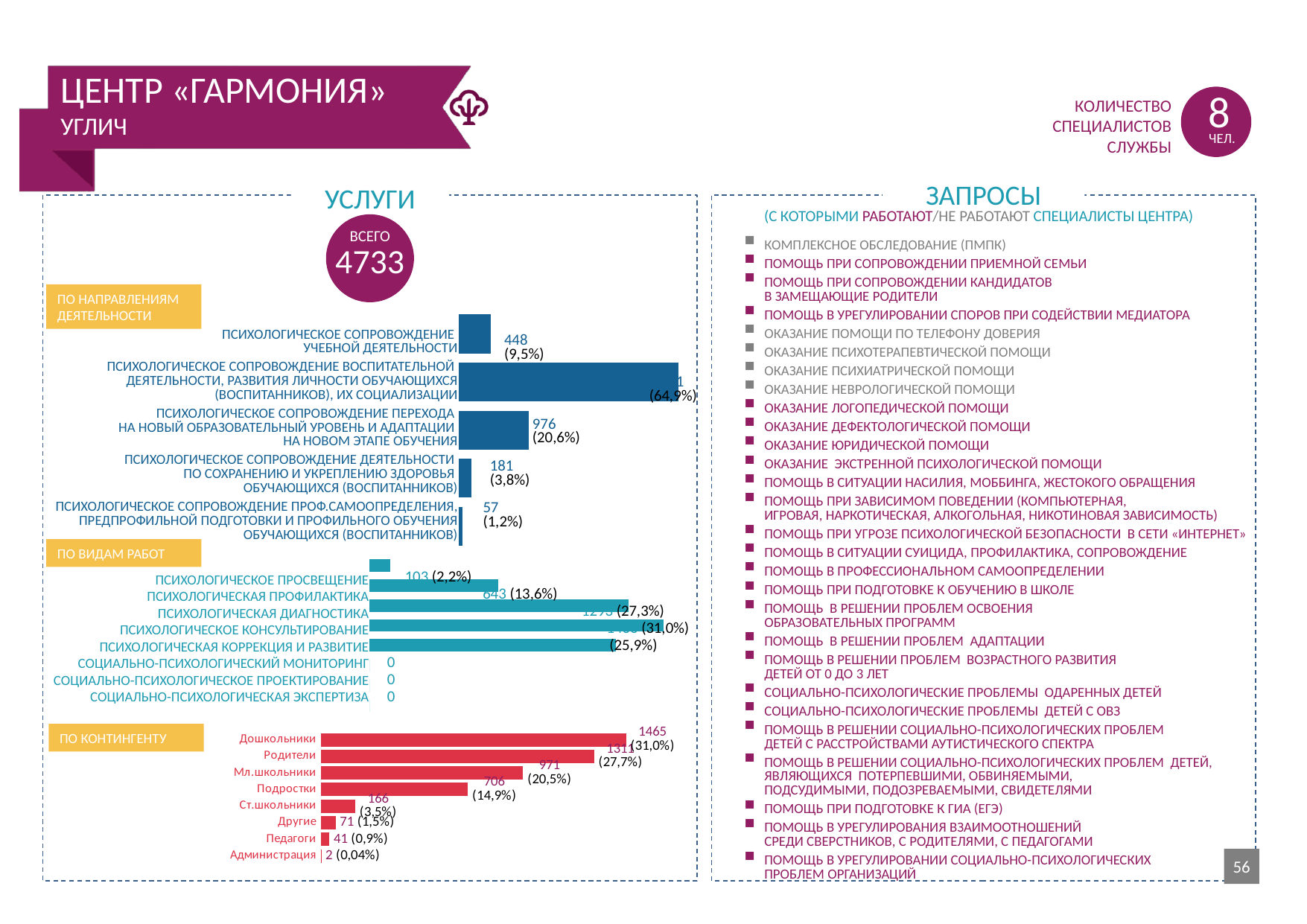
In the 'По видам работ' chart, what is the value for 'Психологическая профилактика'? 643 In the 'По контингенту' chart, which category has the highest value? Дошкольники In the 'По направлениям деятельности' chart, which category has the lowest value? Психологическое сопровождение проф.самоопределения, предпрофильной подготовки и профильного обучения обучающихся (воспитанников) In the 'По видам работ' chart, which is larger: 'Психологическая диагностика' or 'Психологическая профилактика'? Психологическая диагностика In the 'По направлениям деятельности' chart, what is the value for 'Психологическое сопровождение учебной деятельности'? 448 What total ('ВСЕГО') is shown for the 'УСЛУГИ' section? 4733 In the 'По направлениям деятельности' chart, what is the difference between the values for 'Психологическое сопровождение перехода на новый образовательный уровень' and 'Психологическое сопровождение учебной деятельности'? 528 In the 'По контингенту' chart, what is the difference between the values for 'Мл.школьники' and 'Ст.школьники'? 805 In the 'По видам работ' chart, what percentage is shown for 'Психологическое консультирование'? 31,0% In the 'По видам работ' chart, how many categories have a value of 0? 3 In the 'По контингенту' chart, what is the value for 'Подростки'? 706 In the 'По направлениям деятельности' chart, what percentage is shown for 'Психологическое сопровождение перехода на новый образовательный уровень и адаптации на новом этапе обучения'? 20,6%